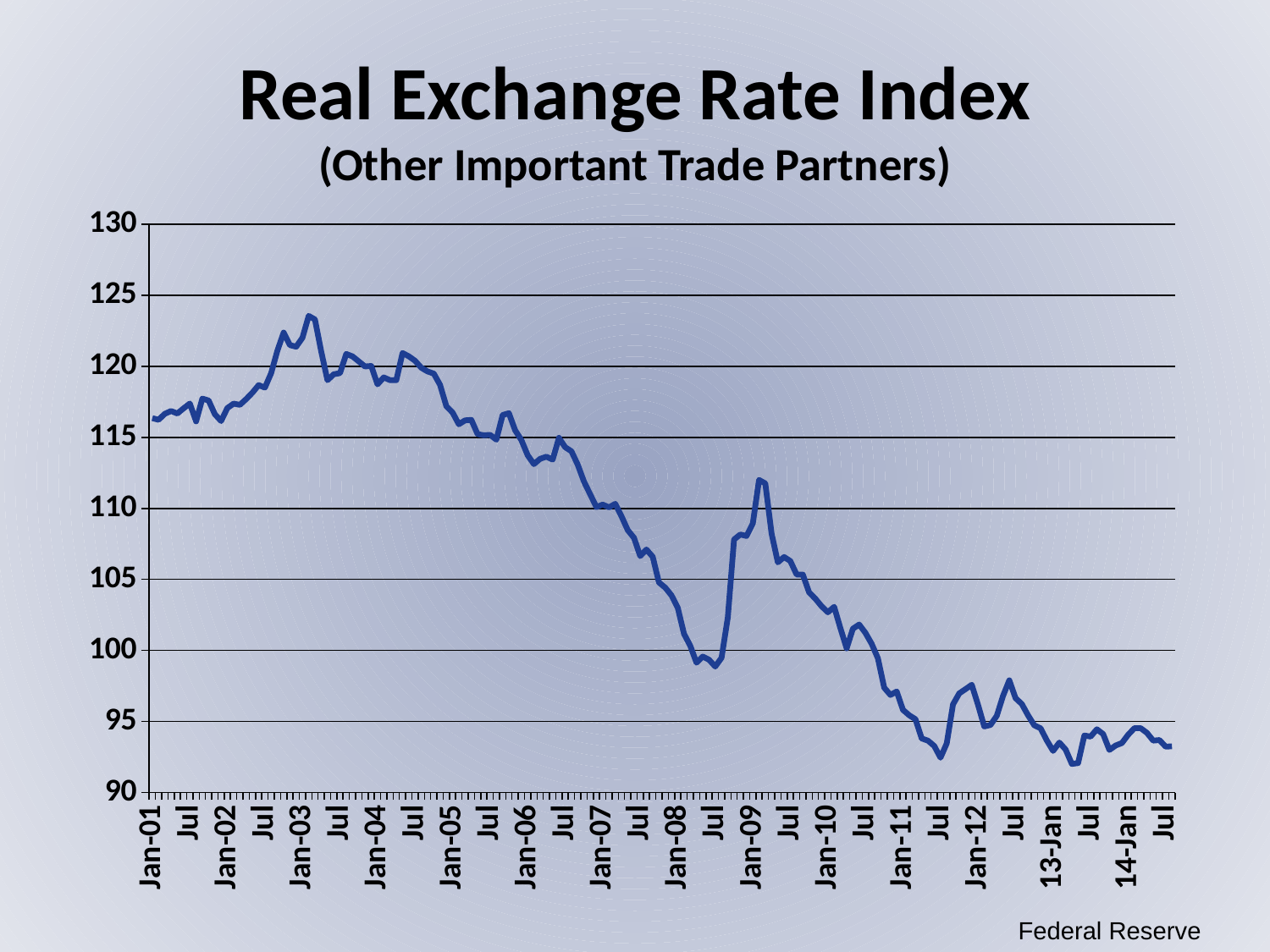
Which is higher, the index value at Jan-01 or at Jan-12? Jan-01 What kind of chart is shown on the slide? line chart What source is cited for the chart? Federal Reserve How many lines are plotted on the chart? 1 Is the value of the index at Jan-03 greater or less than 120? greater Is the value of the index at Jan-11 greater or less than 100? less Around which x-axis label does the index reach its highest point? Jan-03 Overall, does the Real Exchange Rate Index rise or fall from Jan-01 to Jul-14? fall Is the value of the index at Jan-01 greater or less than 110? greater Which is higher, the index value at Jan-03 or at Jan-07? Jan-03